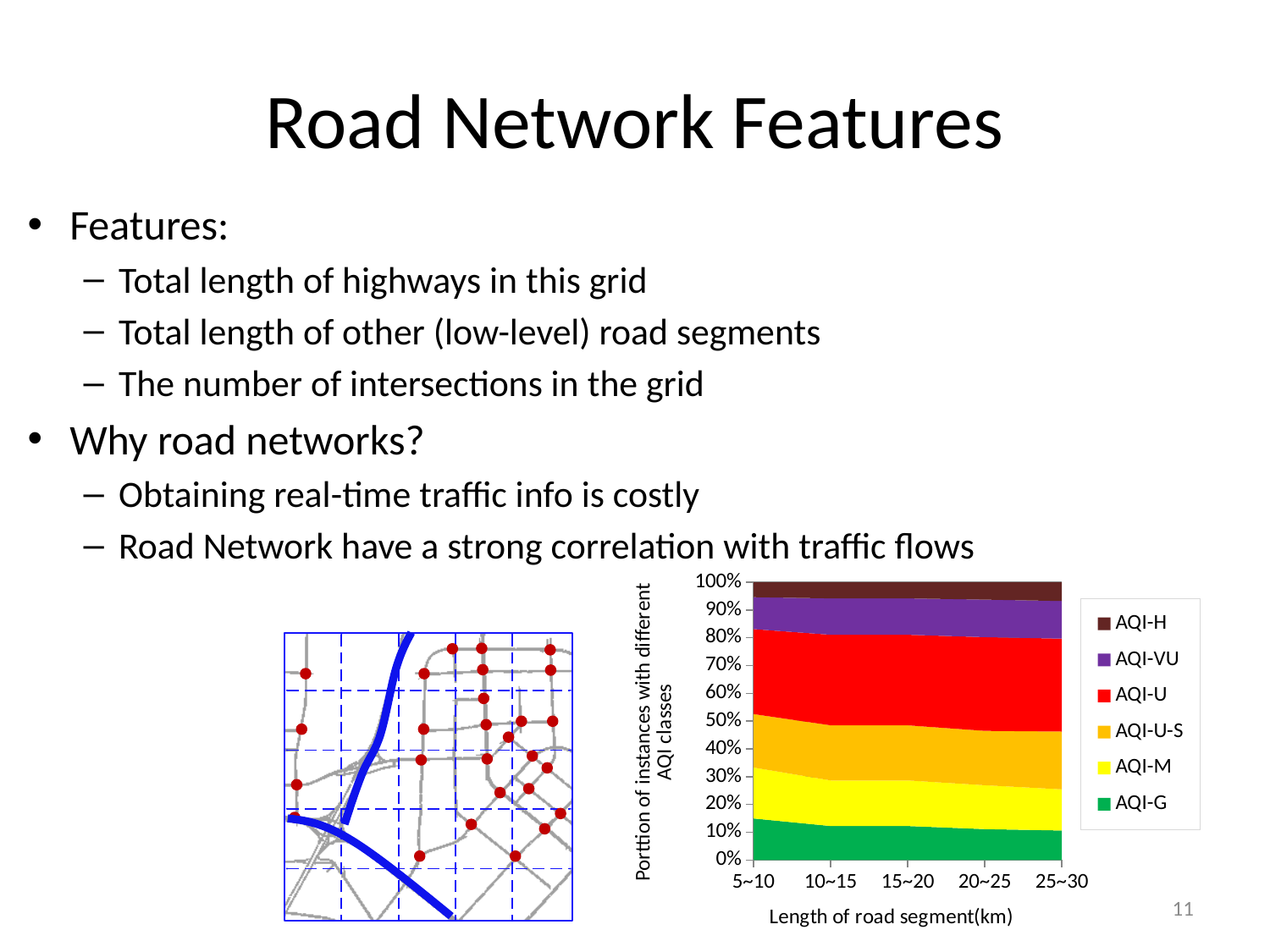
Does the portion of AQI-G instances rise or fall as the length of road segment increases along the x axis? fall For the 5~10 category, which band is larger: AQI-U or AQI-G? AQI-U Which AQI class is listed first (at the top) in the chart's legend? AQI-H What kind of chart is shown on the slide? stacked area chart Is the portion of AQI-G instances larger for the 5~10 category or the 25~30 category? 5~10 Is the cumulative top of the AQI-VU band for the 5~10 category greater or less than 90%? greater Is the portion of AQI-G instances for the 5~10 category greater or less than 10%? greater Is the cumulative top of the AQI-U band for the 5~10 category greater or less than 80%? greater How many road-segment length categories are shown on the x axis of the chart? 5 How many series does the chart's legend list? 6 What is the x-axis title of the chart? Length of road segment(km) What is the highest value shown on the chart's y axis? 100%